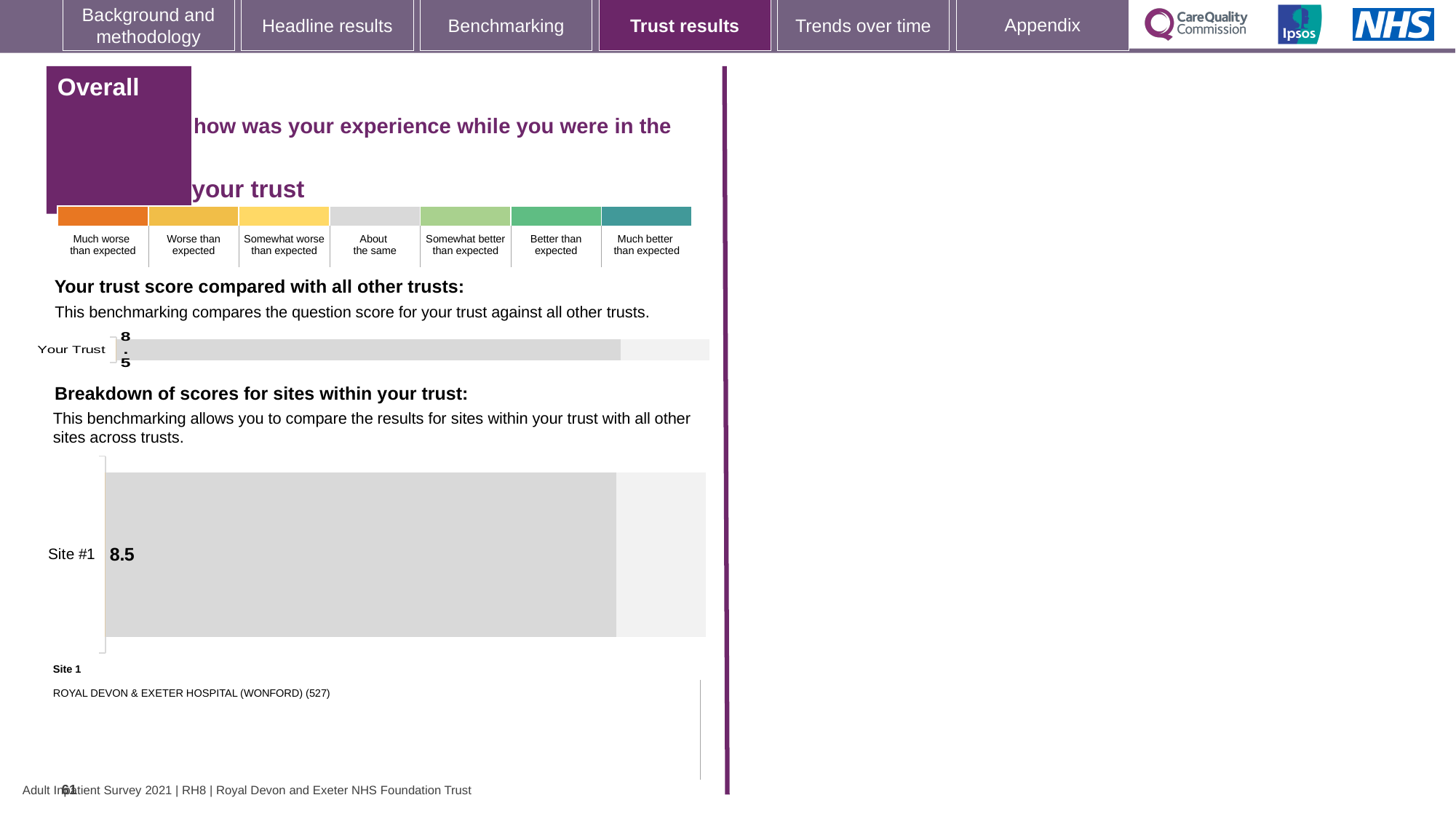
In the 'Breakdown of scores for sites within your trust' chart, which hospital is Site 1? ROYAL DEVON & EXETER HOSPITAL (WONFORD) (527) How many sites are plotted in the 'Breakdown of scores for sites within your trust' chart? 1 What is the difference between the Site #1 score in the 'Breakdown of scores for sites within your trust' chart and the Your Trust score in the 'Your trust score compared with all other trusts' chart? 0 What kind of chart is the 'Your trust score compared with all other trusts' chart? bar chart In the 'Your trust score compared with all other trusts' chart, what is the score for Your Trust? 8.5 What is the label of the single bar in the 'Your trust score compared with all other trusts' chart? Your Trust How many categories are plotted in the 'Your trust score compared with all other trusts' chart? 1 In the 'Breakdown of scores for sites within your trust' chart, what is the score for Site #1? 8.5 How many rating categories does the colour key above the charts list? 7 What kind of chart is the 'Breakdown of scores for sites within your trust' chart? bar chart